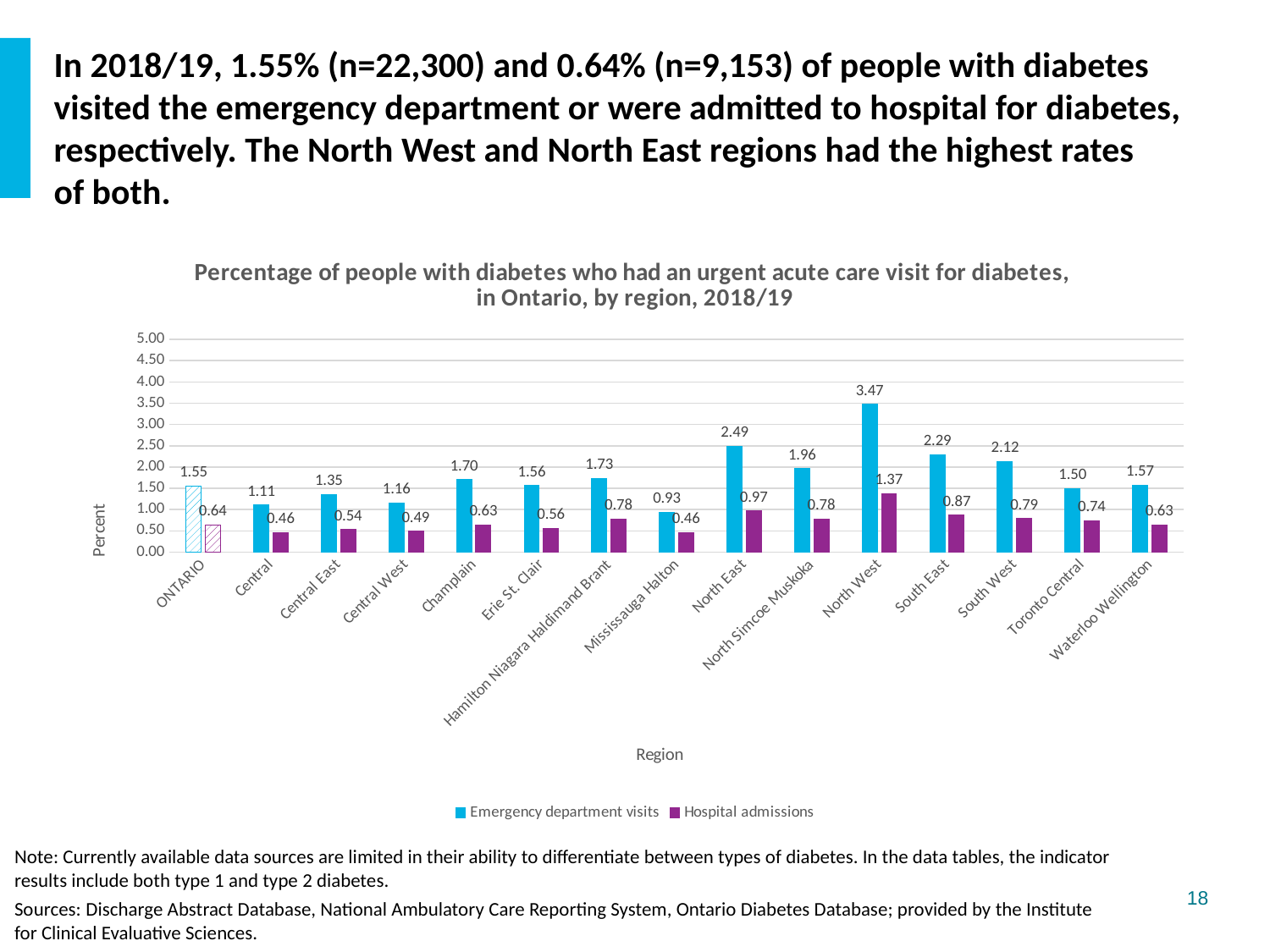
What is the value for Hospital admissions in the South East region? 0.87 Which region has the larger value for Emergency department visits, North East or South East? North East What is the value for Emergency department visits in the North West region? 3.47 Which region has the highest value for Emergency department visits? North West Is the value for Emergency department visits in the North East region greater or less than 2.00? greater Which region has the lowest value for Emergency department visits? Mississauga Halton What kind of chart is shown on the slide? Bar chart What is the difference between Emergency department visits and Hospital admissions in the North West region? 2.10 How many regions are shown on the x axis of the chart? 15 Which region has the highest value for Hospital admissions? North West How many series does the legend list? 2 What is the value for Hospital admissions for ONTARIO? 0.64